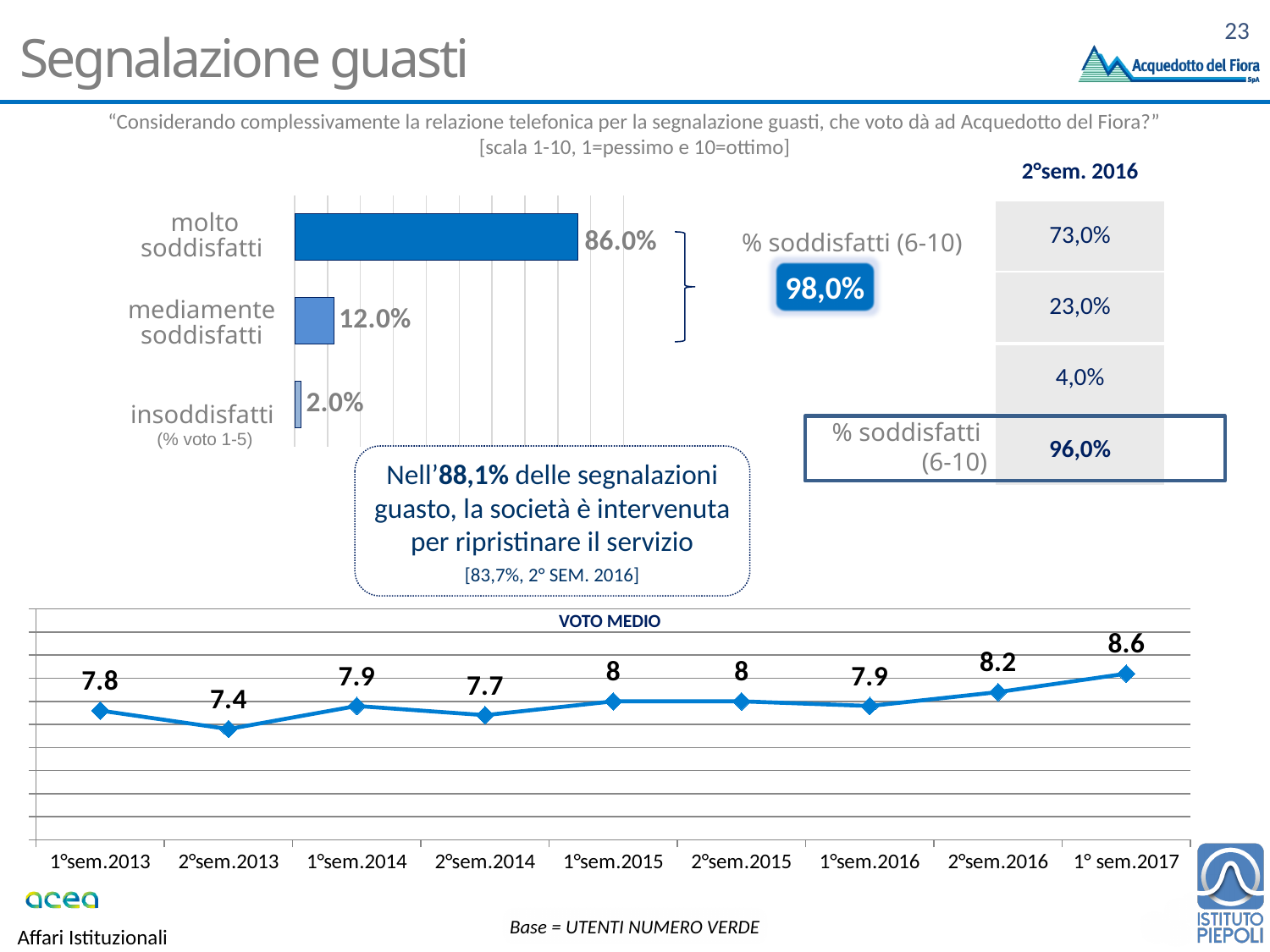
In the VOTO MEDIO line chart, which period has the highest value? 1° sem.2017 In the VOTO MEDIO line chart, what is the value for 1° sem.2017? 8.6 In the top bar chart, what is the value for "molto soddisfatti"? 86.0% In the VOTO MEDIO line chart, how many periods are plotted? 9 In the top bar chart, what is the difference between "molto soddisfatti" and "mediamente soddisfatti"? 74.0% In the top bar chart, what is the value for "mediamente soddisfatti"? 12.0% In the top bar chart, what is the value for "insoddisfatti"? 2.0% What kind of chart is the top chart on the slide? bar chart In the VOTO MEDIO line chart, what is the difference between 1° sem.2017 and 2°sem.2016? 0.4 In the VOTO MEDIO line chart, what is the value for 2°sem.2013? 7.4 In the top bar chart, which category has the lowest value? insoddisfatti In the VOTO MEDIO line chart, which is larger: the value for 1°sem.2013 or the value for 2°sem.2013? 1°sem.2013